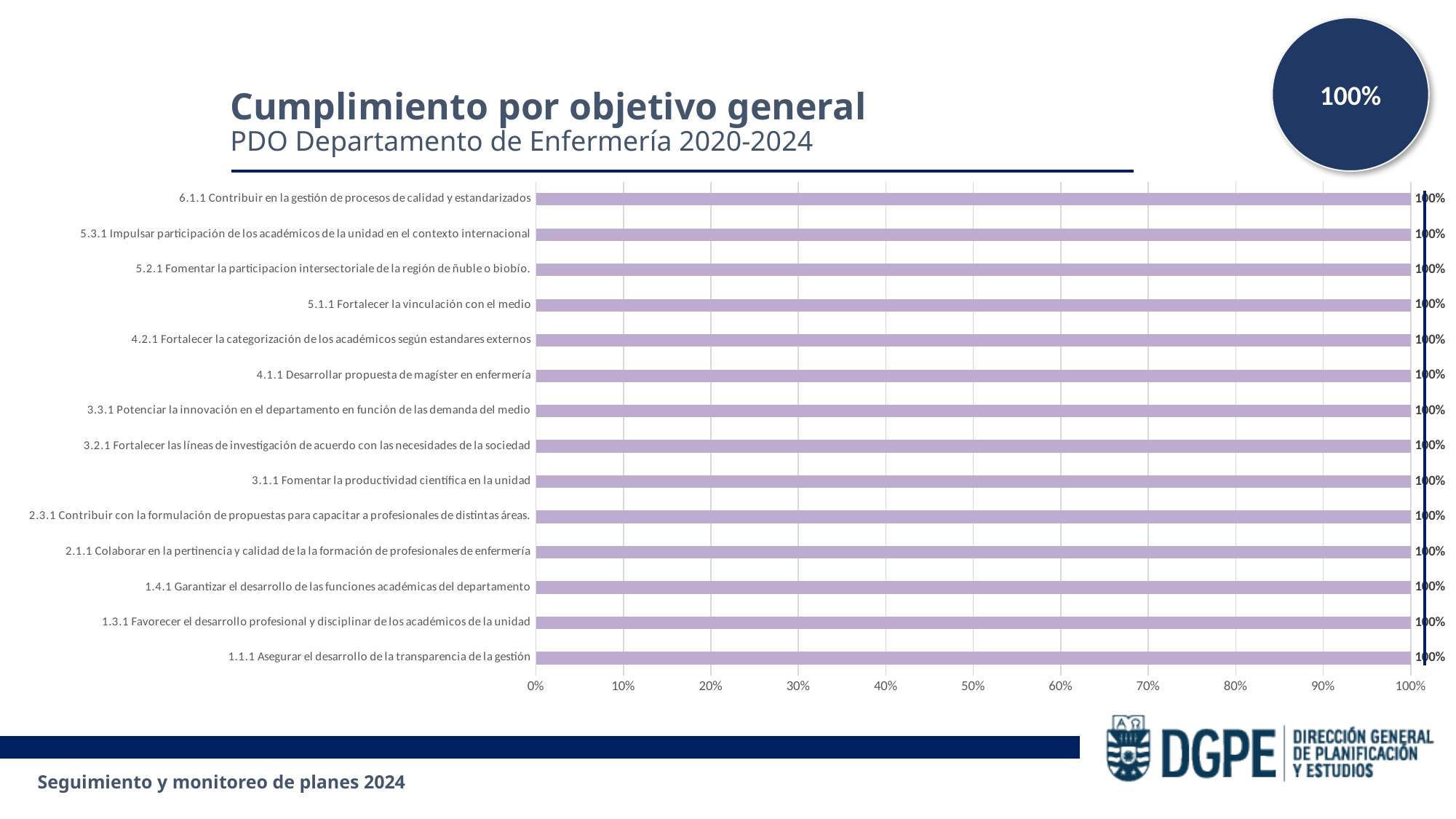
What type of chart is shown on the slide? bar chart Is the value for "3.3.1 Potenciar la innovación en el departamento en función de las demanda del medio" greater or less than 90%? greater What is the difference between the values for "5.1.1 Fortalecer la vinculación con el medio" and "2.1.1 Colaborar en la pertinencia y calidad de la la formación de profesionales de enfermería"? 0% Is the value for "1.4.1 Garantizar el desarrollo de las funciones académicas del departamento" greater or less than 50%? greater What is the value for "6.1.1 Contribuir en la gestión de procesos de calidad y estandarizados"? 100% What is the value for "1.1.1 Asegurar el desarrollo de la transparencia de la gestión"? 100% What is the value for "4.1.1 Desarrollar propuesta de magíster en enfermería"? 100% What is the value for "3.1.1 Fomentar la productividad científica en la unidad"? 100% How many objectives (categories) are plotted in the chart? 14 What is the highest value shown on the x axis of the chart? 100% What is the title of the chart? Cumplimiento por objetivo general